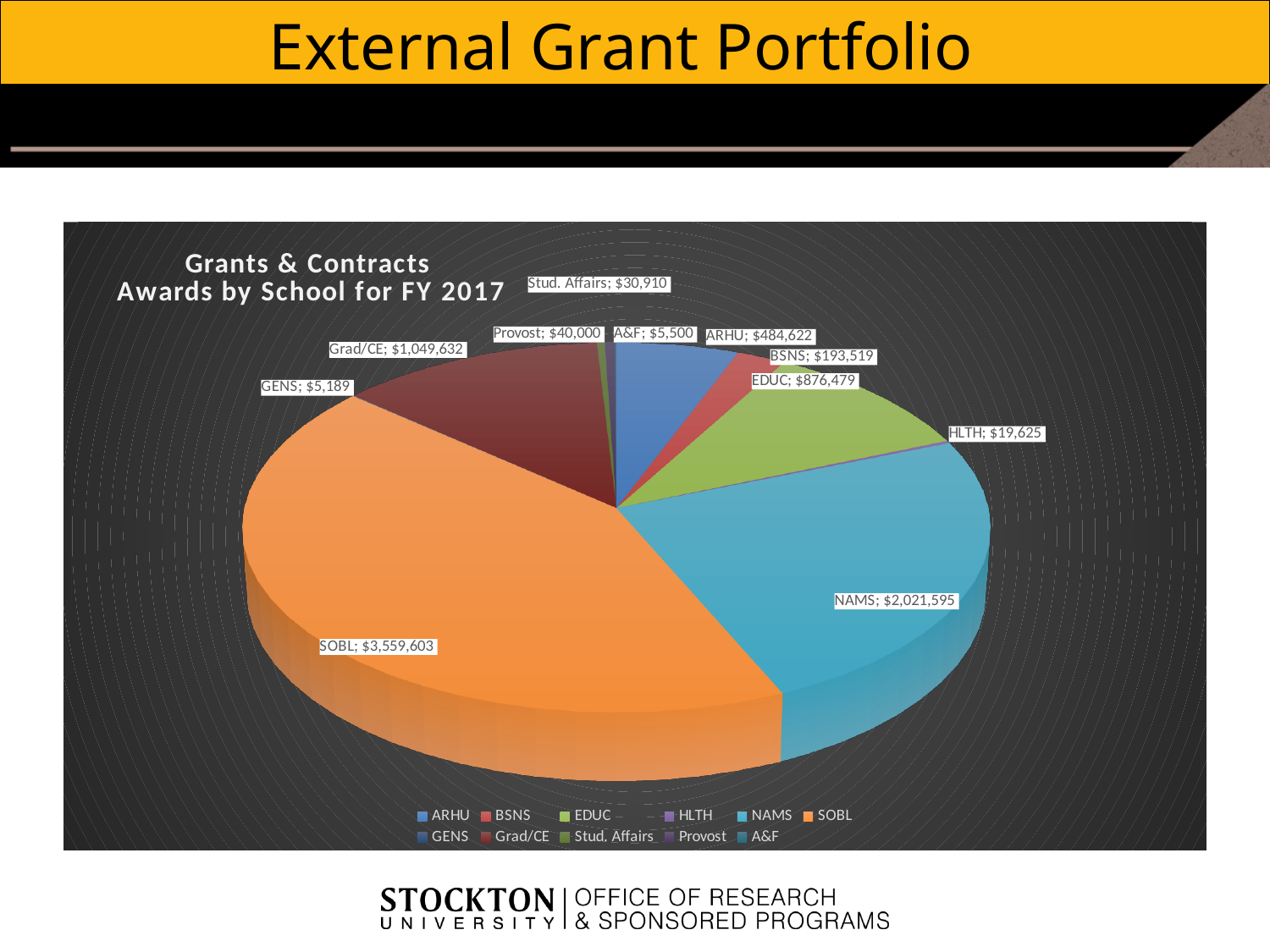
What is the award amount for Grad/CE? $1,049,632 What is the award amount for NAMS? $2,021,595 What is the award amount for HLTH? $19,625 Which school has the largest award amount? SOBL What is the difference between the SOBL and NAMS award amounts? $1,538,008 What type of chart is shown on the slide? Pie chart Which has a larger award amount, EDUC or Grad/CE? Grad/CE What is the title of the chart? Grants & Contracts Awards by School for FY 2017 What is the award amount for SOBL? $3,559,603 What is the difference between the ARHU and BSNS award amounts? $291,103 Which category has the smallest award amount? GENS How many categories are shown in the pie chart? 11